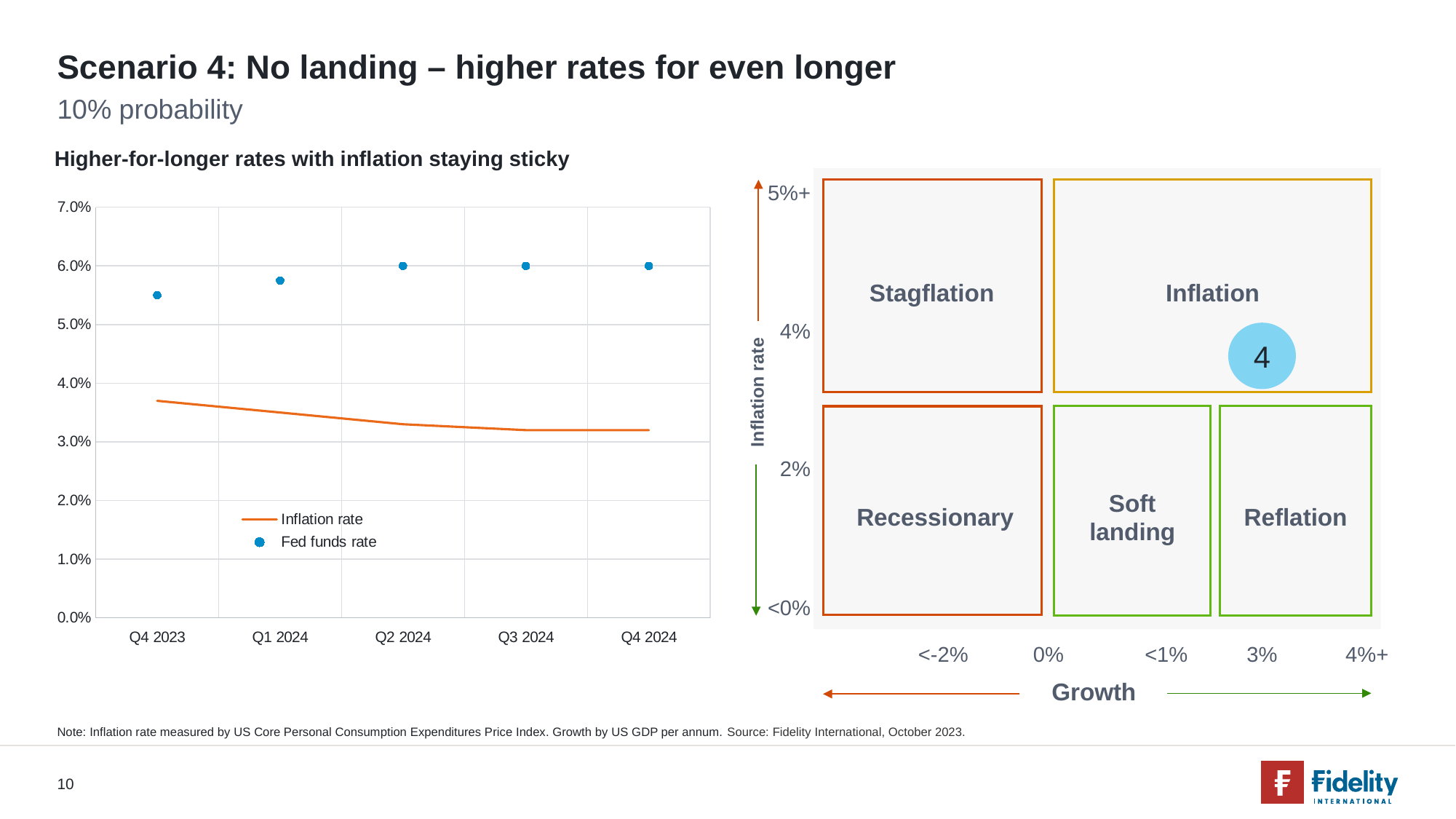
What are the two series named in the chart's legend? Inflation rate and Fed funds rate Is the Fed funds rate for Q4 2023 greater or less than 5.0%? greater Which quarter has the highest Inflation rate? Q4 2023 Is the Inflation rate for Q4 2024 greater or less than 4.0%? less Which quarter has the lowest Fed funds rate? Q4 2023 What is the Fed funds rate for Q2 2024? 6.0% Does the Inflation rate series rise or fall from Q4 2023 to Q4 2024? fall In Q4 2024, which is higher: the Fed funds rate or the Inflation rate? Fed funds rate Is the Inflation rate for Q4 2023 greater or less than 3.0%? greater How many series does the chart's legend list? 2 How many quarters are shown on the x axis of the chart? 5 What is the title of the chart? Higher-for-longer rates with inflation staying sticky